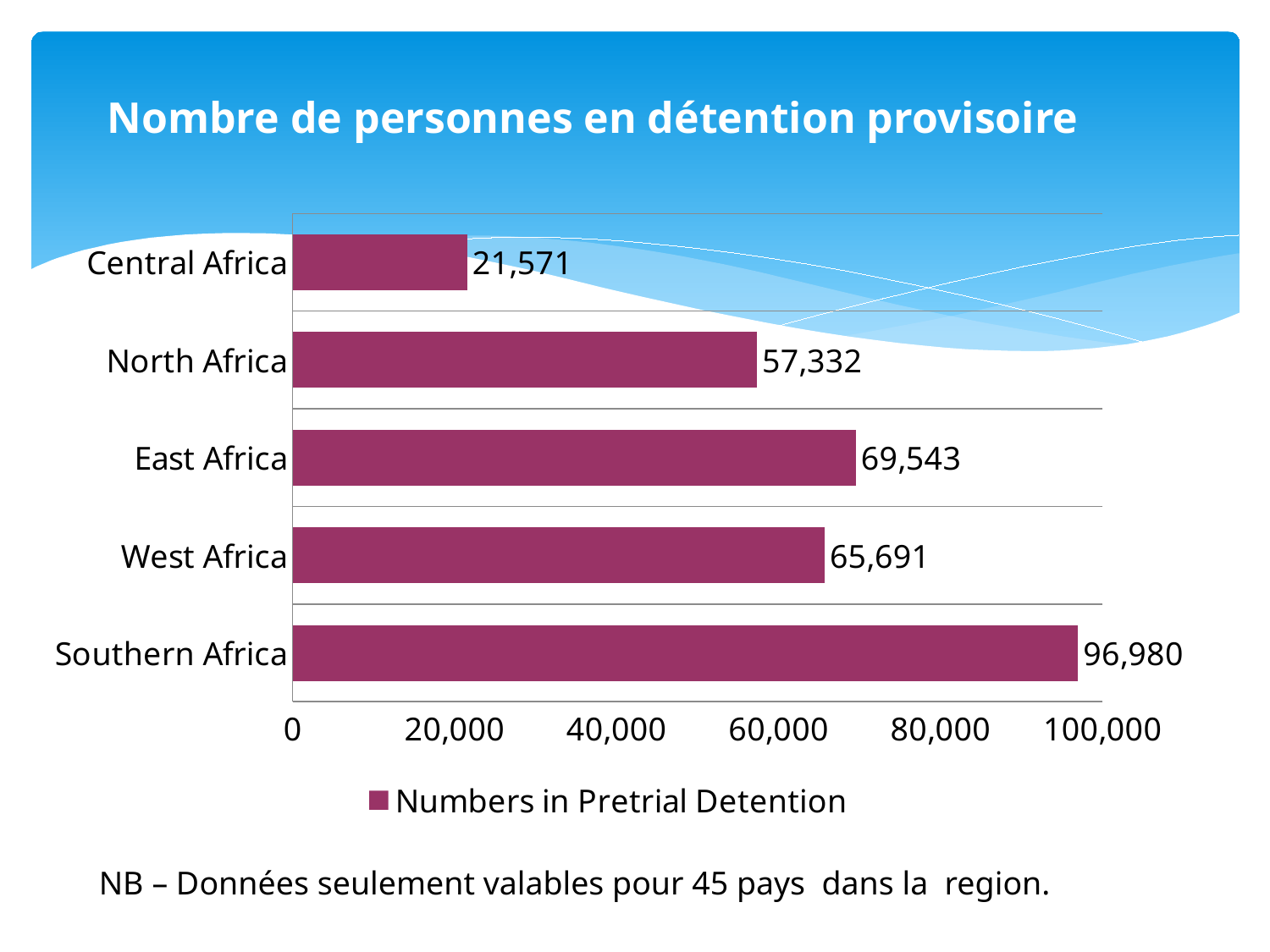
What is the difference between the values for East Africa and West Africa? 3,852 What series name does the legend show? Numbers in Pretrial Detention Which is larger, the value for East Africa or the value for North Africa? East Africa What is the value for North Africa? 57,332 How many regions are shown in the chart? 5 Which region has the lowest number in pretrial detention? Central Africa Which region has the highest number in pretrial detention? Southern Africa What is the value for Southern Africa? 96,980 What kind of chart is shown on the slide? Bar chart What is the value for Central Africa? 21,571 Is the value for West Africa greater or less than 60,000? greater What is the difference between the values for Southern Africa and Central Africa? 75,409